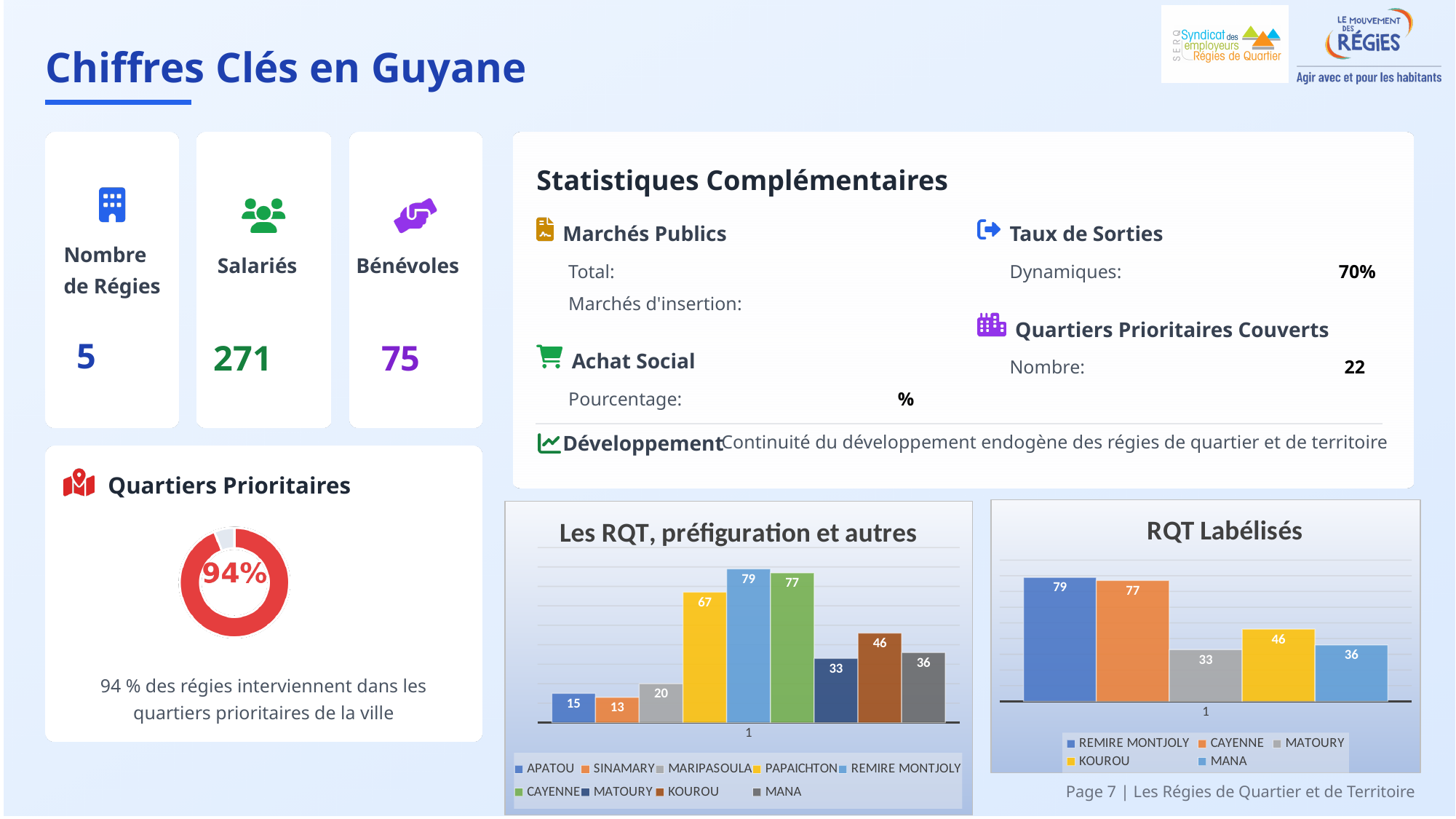
In the chart 'Les RQT, préfiguration et autres', what is the difference between the values for KOUROU and MATOURY? 13 In the chart 'RQT Labélisés', what is the value for MANA? 36 In the chart 'RQT Labélisés', which series has the lowest value? MATOURY In the chart 'Les RQT, préfiguration et autres', what is the value for PAPAICHTON? 67 In the chart 'Les RQT, préfiguration et autres', which series has the highest value? REMIRE MONTJOLY In the 'Quartiers Prioritaires' donut chart, what percentage is shown? 94% In the chart 'Les RQT, préfiguration et autres', how many series does the legend list? 9 What kind of chart is 'RQT Labélisés'? Bar chart In the chart 'Les RQT, préfiguration et autres', which series has the lowest value? SINAMARY In the chart 'Les RQT, préfiguration et autres', what is the value for SINAMARY? 13 In the chart 'RQT Labélisés', which is larger, the value for CAYENNE or the value for KOUROU? CAYENNE In the chart 'RQT Labélisés', how many series does the legend list? 5